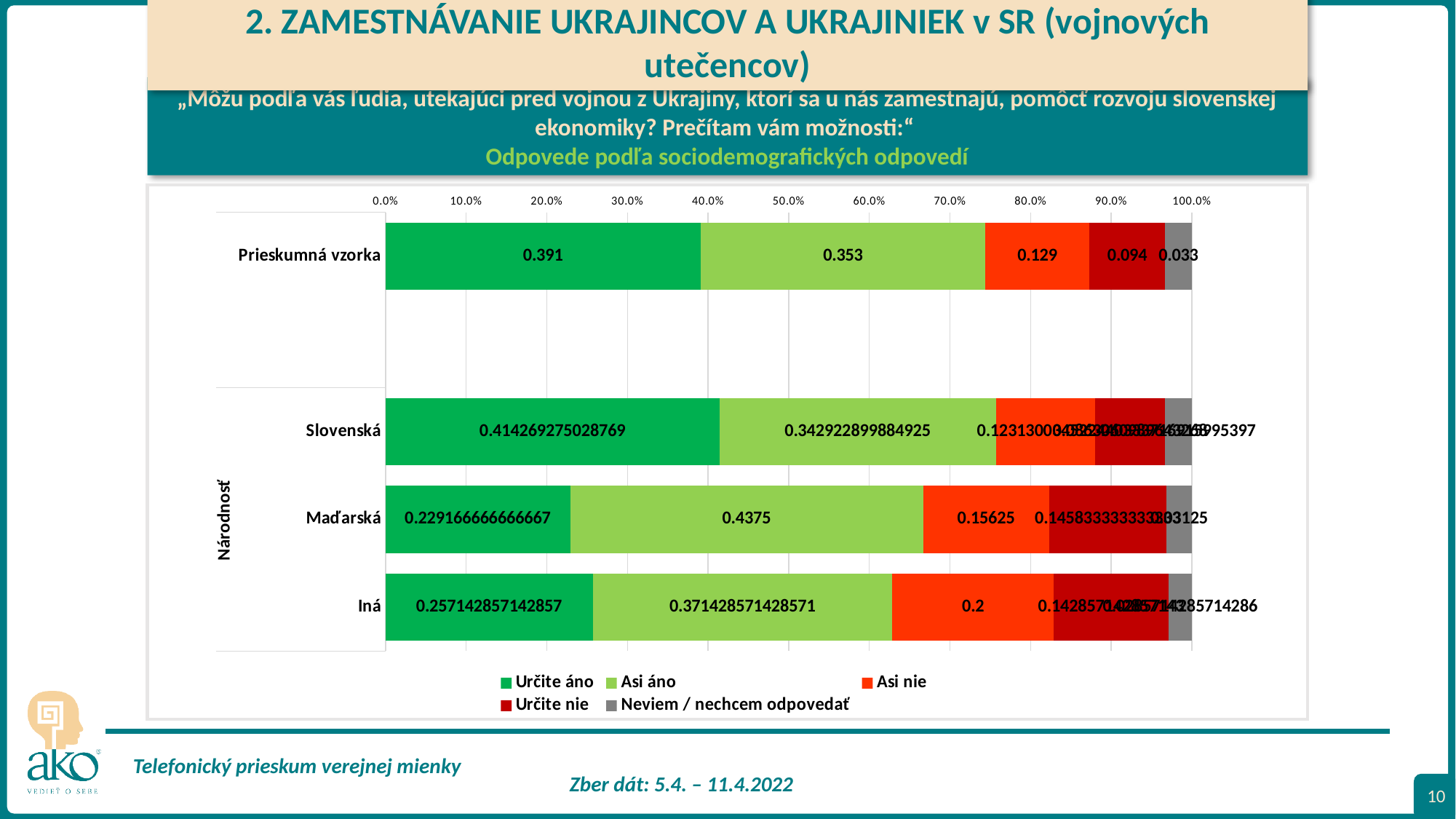
For Prieskumná vzorka, which is larger: Určite áno or Asi áno? Určite áno What is the value for Neviem / nechcem odpovedať for Prieskumná vzorka? 0.033 What is the value for Asi nie for Iná? 0.2 Which category has the highest value for Určite áno? Slovenská How many series does the legend list? 5 What is the value for Určite áno for Prieskumná vzorka? 0.391 Which category has the lowest value for Určite áno? Maďarská What is the value for Asi nie for Prieskumná vzorka? 0.129 What is the value for Asi áno for Maďarská? 0.4375 What is the difference between Určite áno and Asi áno for Prieskumná vzorka? 0.038 What kind of chart is shown on the slide? Stacked bar chart Is the value for Určite áno for Slovenská greater or less than 40.0%? greater